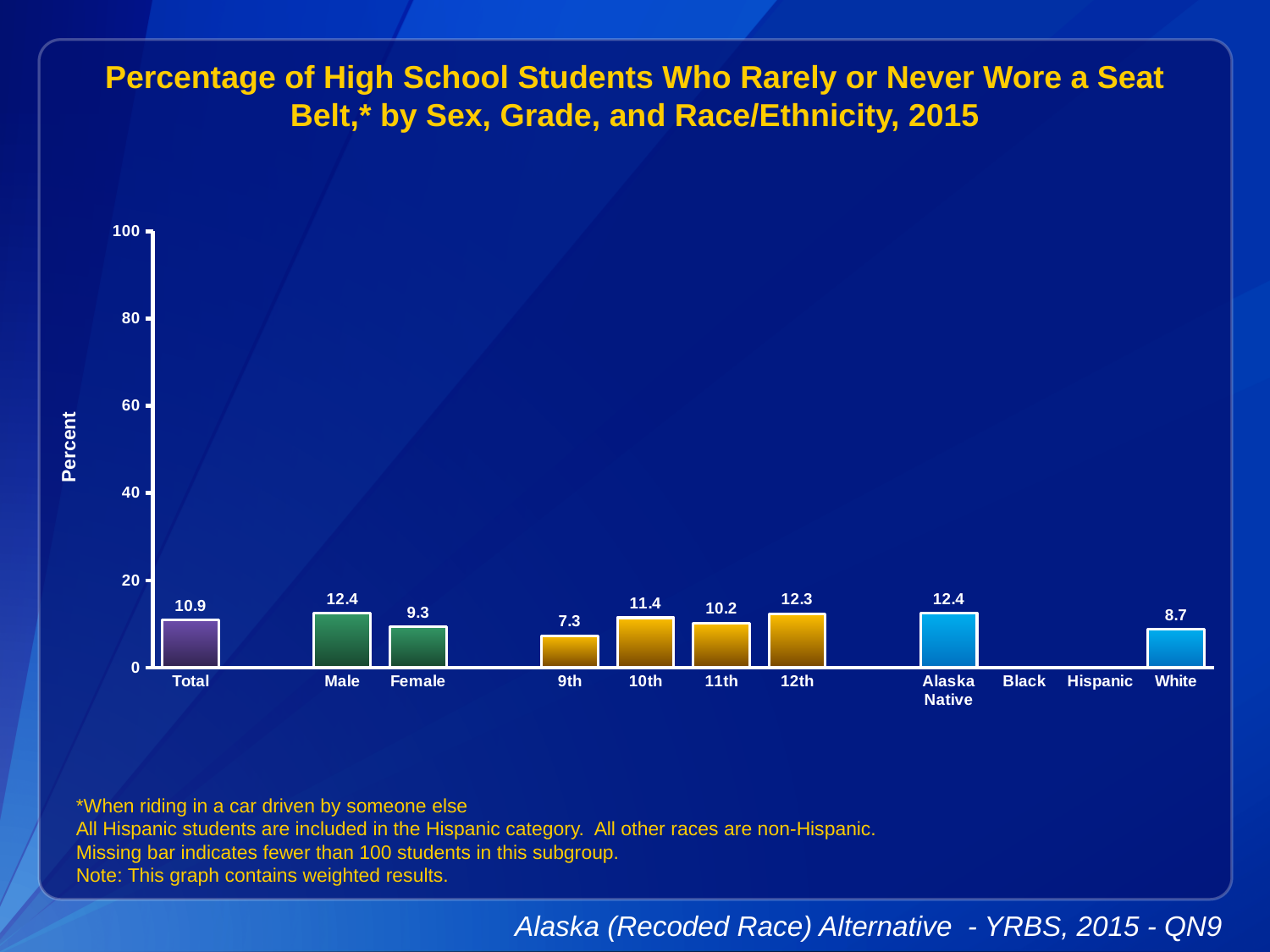
What is the label on the vertical axis of the chart? Percent What percentage of high school students in total rarely or never wore a seat belt? 10.9 What is the value shown for Alaska Native students? 12.4 What is the value shown for 12th grade students? 12.3 What is the difference between the values for Male and Female students? 3.1 Which grade has the lowest percentage of students who rarely or never wore a seat belt? 9th Which grade has the highest percentage of students who rarely or never wore a seat belt? 12th What kind of chart is shown on the slide? Bar chart Which is larger, the value for 10th grade or the value for 11th grade? 10th grade Is the value for White students greater or less than 20? less How many categories on the x axis have no bar plotted? 2 What is the value shown for Female students? 9.3